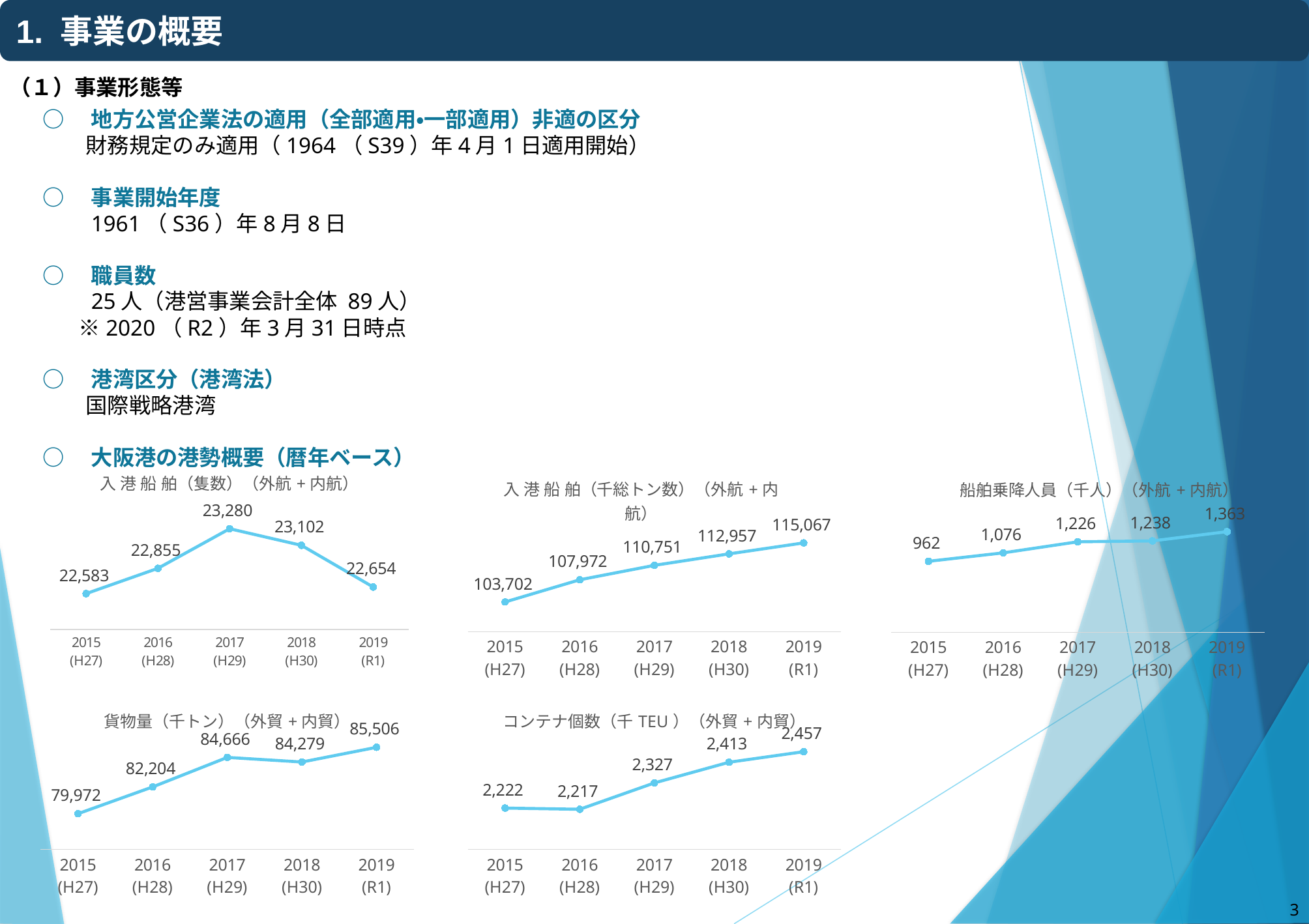
In the 船舶乗降人員（千人）（外航＋内航） chart, what is the value for 2016 (H28)? 1,076 How many charts are shown on the slide, and what type are they? 5 line charts In the 入港船舶（隻数）（外航＋内航） chart, what is the value for 2017 (H29)? 23,280 In the コンテナ個数（千TEU）（外貿＋内貿） chart, what is the value for 2015 (H27)? 2,222 In the コンテナ個数（千TEU）（外貿＋内貿） chart, what is the difference between the 2019 (R1) and 2018 (H30) values? 44 In the 船舶乗降人員（千人）（外航＋内航） chart, which year has the highest value? 2019 (R1) In the 入港船舶（千総トン数）（外航＋内航） chart, what is the value for 2019 (R1)? 115,067 In the 入港船舶（千総トン数）（外航＋内航） chart, what is the difference between the 2019 (R1) and 2015 (H27) values? 11,365 In the 貨物量（千トン）（外貿＋内貿） chart, which is larger, the value for 2017 (H29) or 2018 (H30)? 2017 (H29) In the 貨物量（千トン）（外貿＋内貿） chart, what is the value for 2018 (H30)? 84,279 In the 入港船舶（千総トン数）（外航＋内航） chart, do the values rise or fall from 2015 to 2019? rise In the 入港船舶（隻数）（外航＋内航） chart, which year has the lowest value? 2015 (H27)